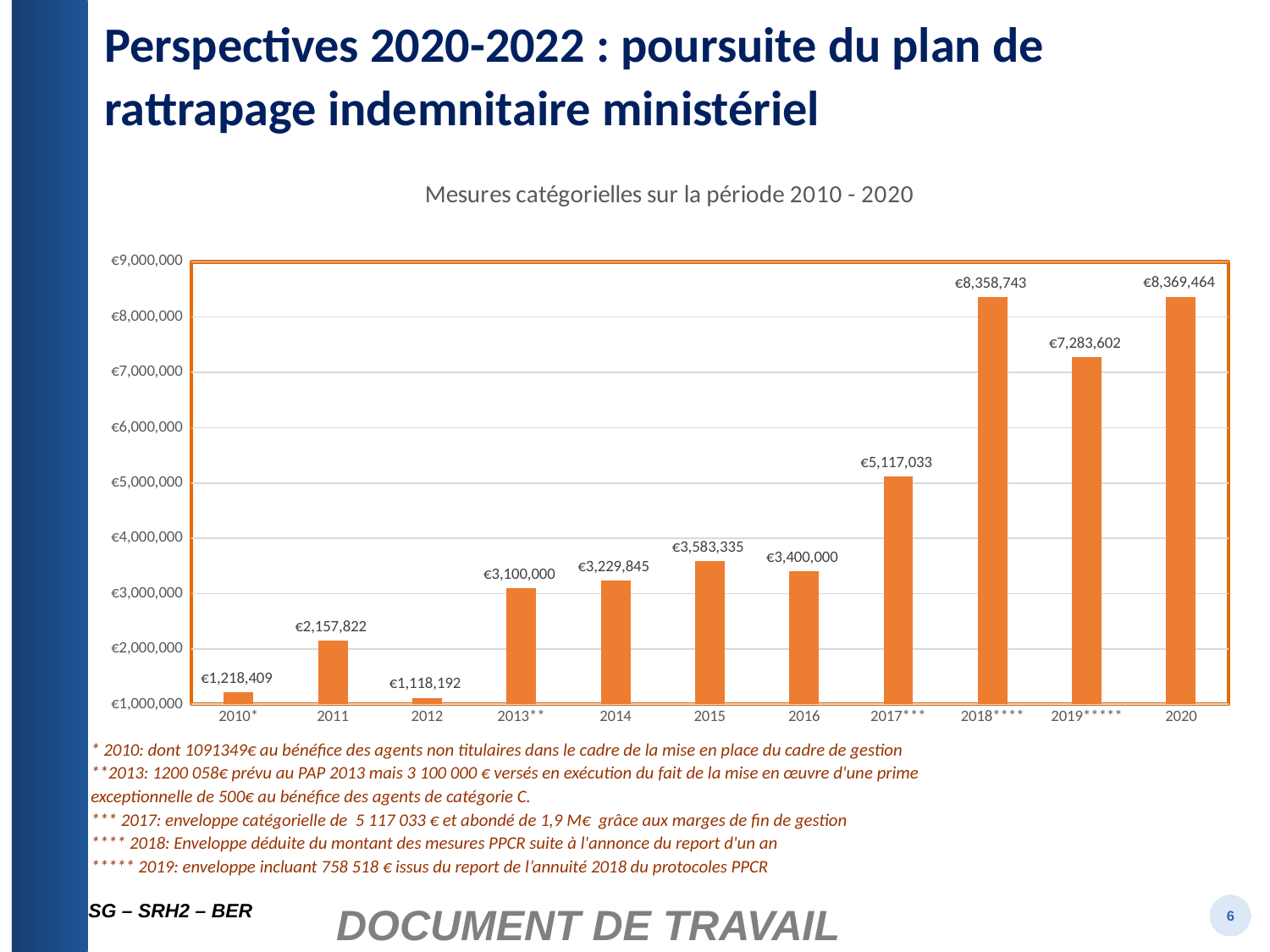
Is the value for 2014 greater or less than €3,000,000? greater How many years are plotted in the chart? 11 What type of chart is shown on the slide? Bar chart Do the values rise or fall from 2013** to 2015? rise What is the difference between the values for 2017*** and 2016? €1,717,033 Which year has the lowest value in the chart? 2012 What is the value shown for 2020? €8,369,464 What is the title of the chart? Mesures catégorielles sur la période 2010 - 2020 Which is larger, the value for 2018**** or the value for 2019*****? 2018**** What is the difference between the values for 2020 and 2019*****? €1,085,862 What is the value shown for 2017***? €5,117,033 What is the value shown for 2011? €2,157,822